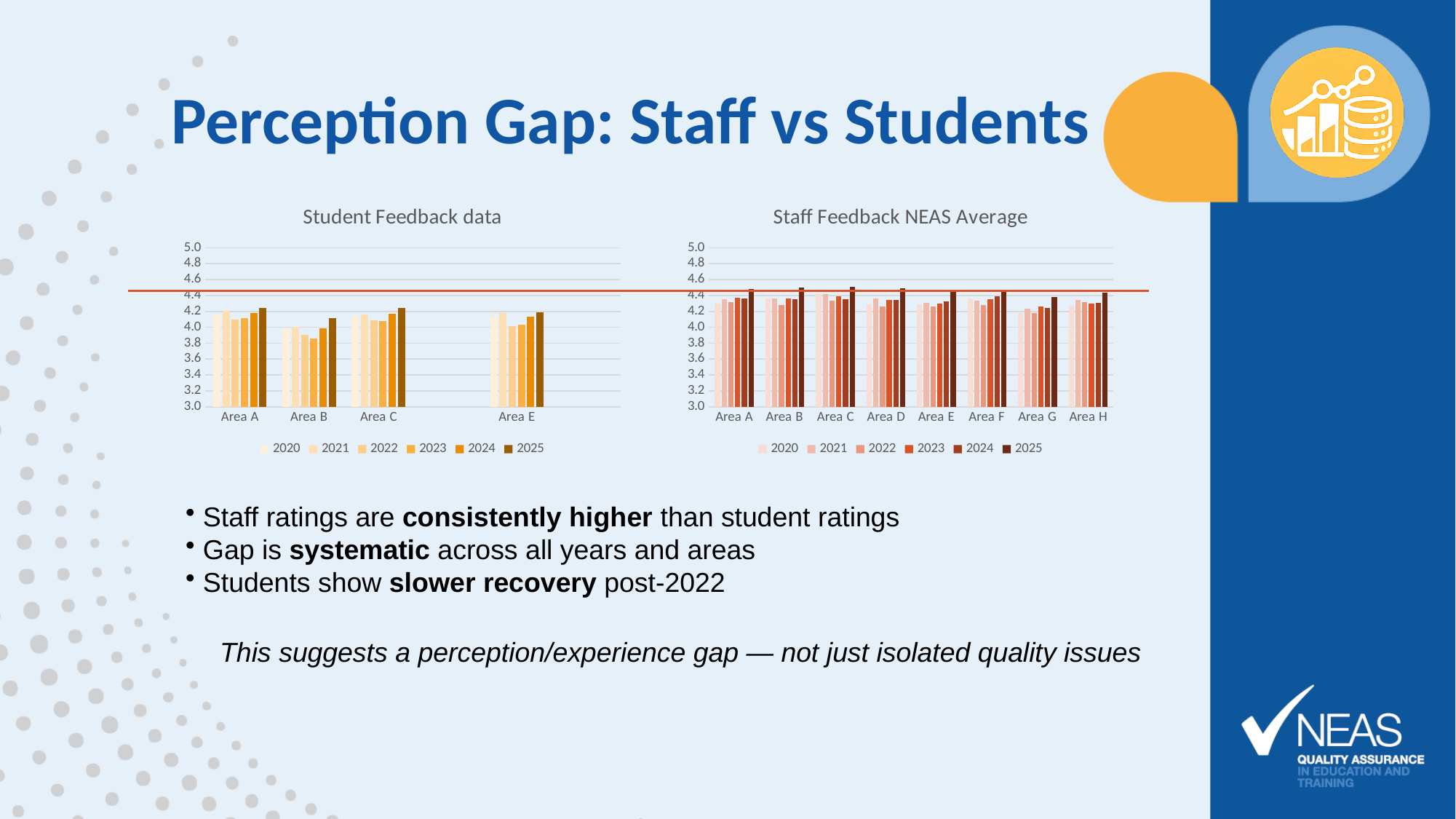
In the 'Student Feedback data' chart, which year has the lowest value for Area B? 2023 In the 'Student Feedback data' chart, which is larger for Area C: the 2022 value or the 2025 value? 2025 In the 'Student Feedback data' chart, which year has the highest value for Area B? 2025 In the 'Student Feedback data' chart, is the value for Area B in 2023 greater or less than 4.0? less What kind of chart is the 'Student Feedback data' chart? bar chart In the 'Staff Feedback NEAS Average' chart, is the value for Area B in 2025 greater or less than 4.4? greater In the 'Staff Feedback NEAS Average' chart, which year has the highest value for Area G? 2025 In the 'Staff Feedback NEAS Average' chart, is the value for Area G in 2022 greater or less than 4.4? less What is the title of the chart on the right of the slide? Staff Feedback NEAS Average How many area categories are labelled on the x axis of the 'Staff Feedback NEAS Average' chart? 8 How many area categories are labelled on the x axis of the 'Student Feedback data' chart? 4 How many series does the legend of the 'Staff Feedback NEAS Average' chart list? 6